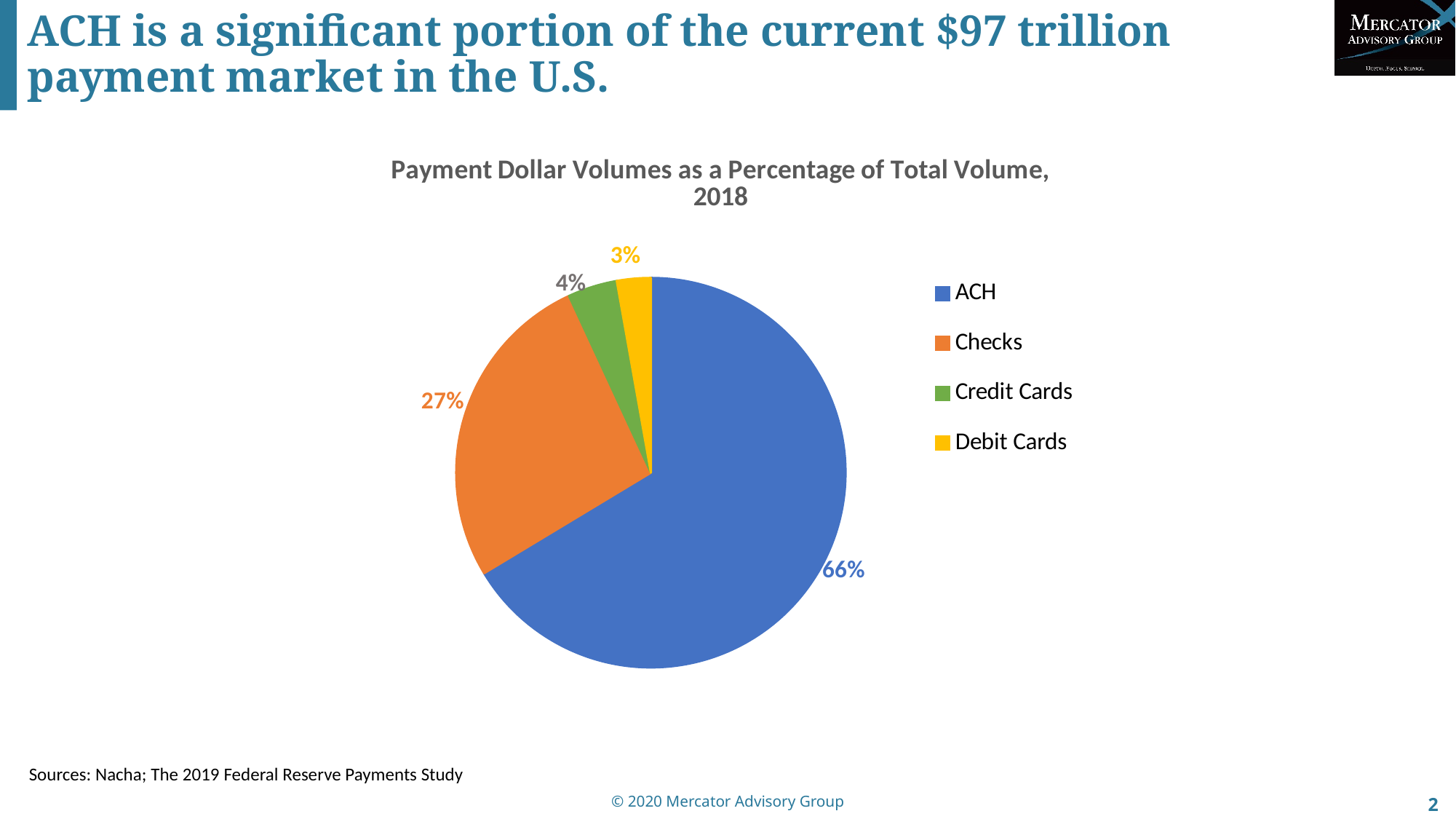
Which category has the largest share of the pie? ACH Which category has the smallest share of the pie? Debit Cards What type of chart is shown on the slide? Pie chart What percentage of total payment dollar volume is Checks? 27% Which has a larger share, Credit Cards or Debit Cards? Credit Cards How many categories does the legend list? 4 What percentage of total payment dollar volume is Debit Cards? 3% What percentage of total payment dollar volume is ACH? 66% What is the difference in percentage points between ACH and Checks? 39 What colour represents Checks in the pie chart? Orange What percentage of total payment dollar volume is Credit Cards? 4% What is the title of the chart? Payment Dollar Volumes as a Percentage of Total Volume, 2018